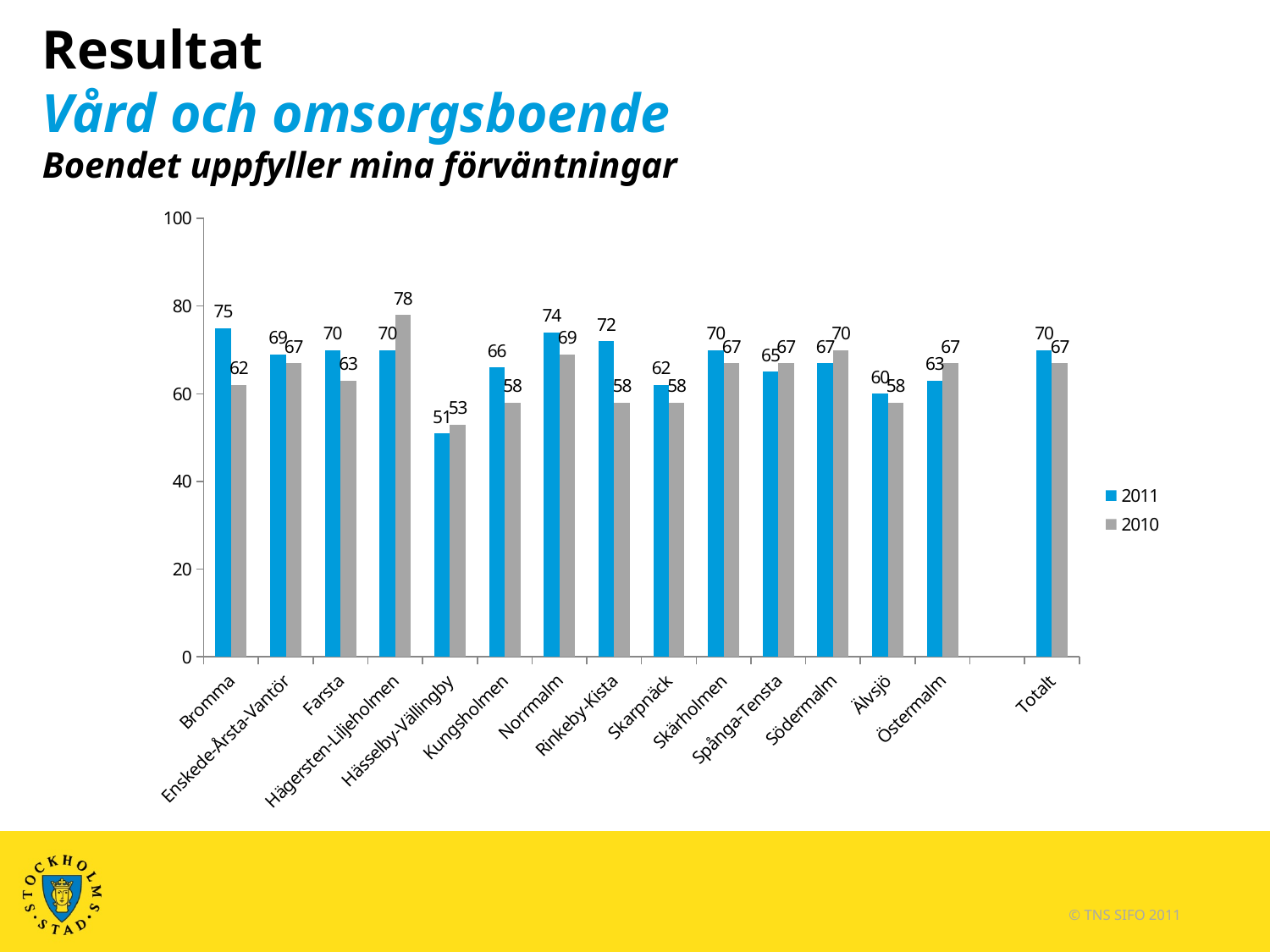
What is the difference between the 2011 and 2010 values for Rinkeby-Kista? 14 How many series does the legend list? 2 What is the 2011 value for Bromma? 75 Which category has the highest 2011 value? Bromma How many categories are shown on the x axis? 15 Which category has the lowest 2011 value? Hässelby-Vällingby What is the difference between the 2011 and 2010 values for Bromma? 13 What is the 2011 value for Totalt? 70 For Södermalm, which is larger: the 2011 value or the 2010 value? 2010 What kind of chart is shown on the slide? Bar chart What is the 2010 value for Hägersten-Liljeholmen? 78 Which category has the highest 2010 value? Hägersten-Liljeholmen